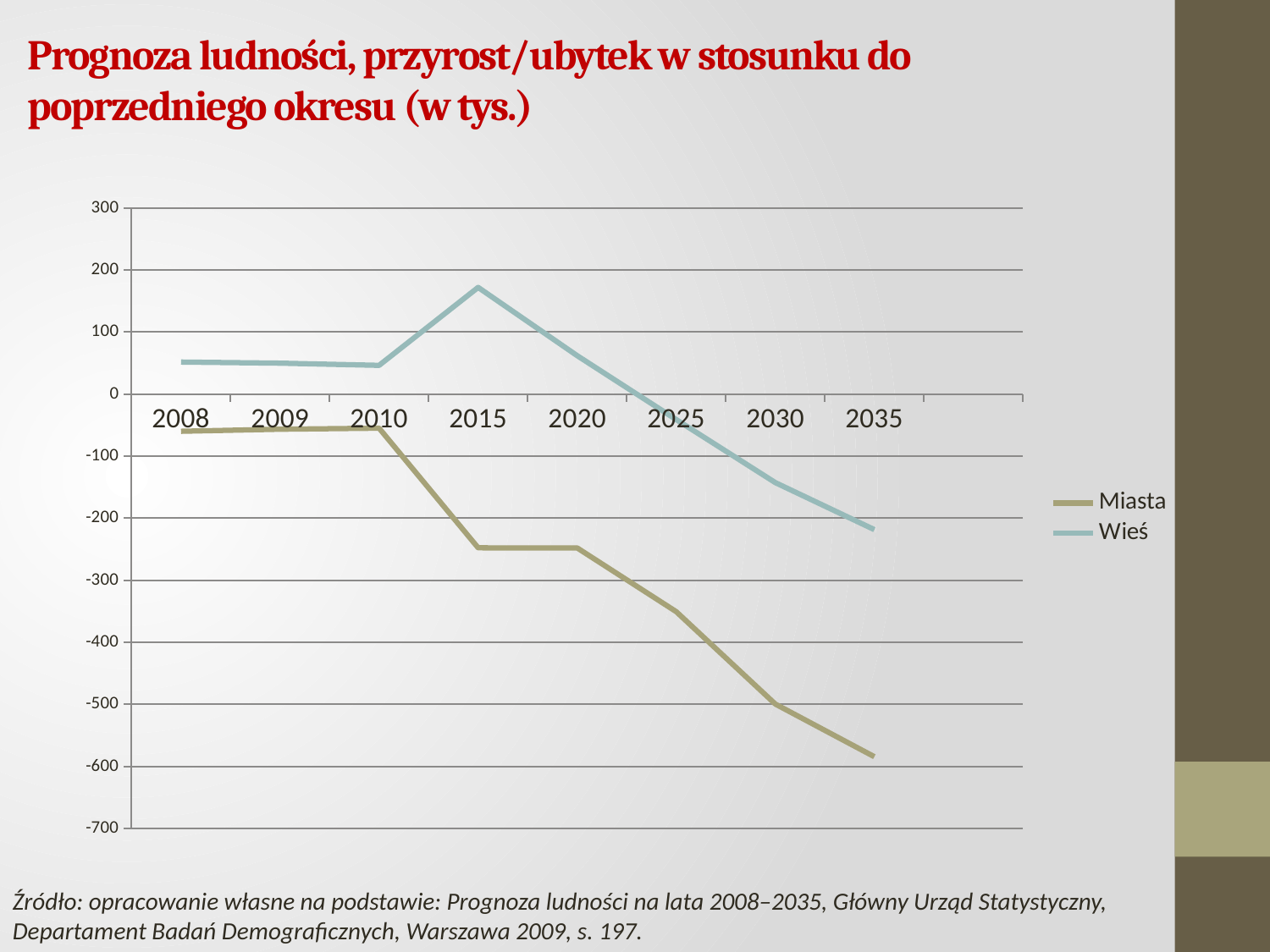
How many years are shown on the x axis? 8 Which series is shown in the legend besides Miasta? Wieś Is the value for Miasta in 2035 greater or less than -500? less What kind of chart is shown on the slide? line chart Is the value for Miasta in 2015 greater or less than -200? less In which year does the Wieś series reach its highest value? 2015 Does the Miasta series rise or fall between 2010 and 2035? fall How many series does the legend list? 2 Which series has the higher value in 2030, Miasta or Wieś? Wieś Is the value for Wieś in 2008 greater or less than 0? greater In which year does the Miasta series reach its lowest value? 2035